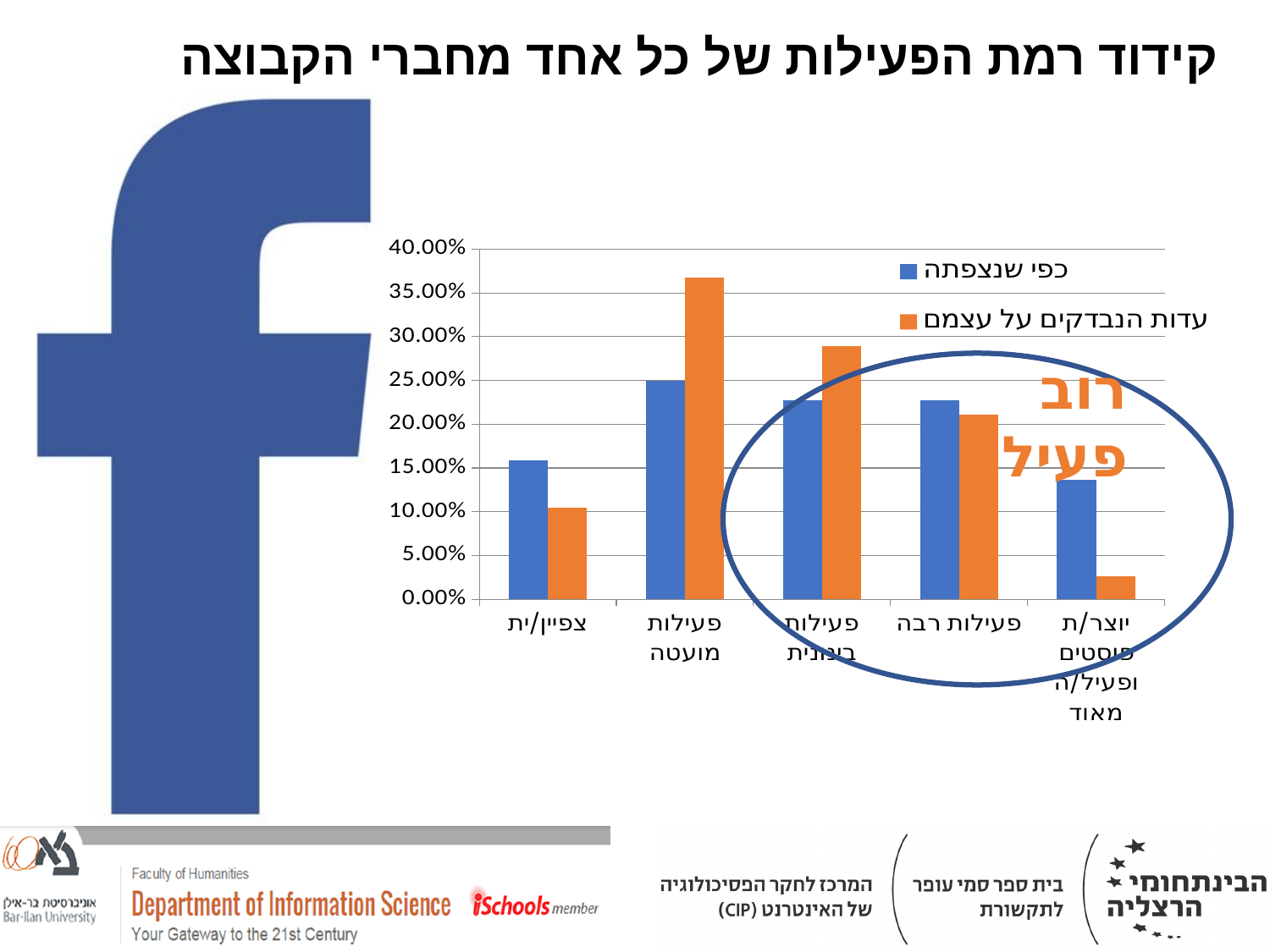
For the category 'צפיין/ית', which series has the larger value: 'כפי שנצפתה' or 'עדות הנבדקים על עצמם'? כפי שנצפתה How many categories are shown on the x axis of the chart? 5 How many series does the chart's legend list? 2 What kind of chart is shown on the slide? bar chart Is the value of 'כפי שנצפתה' for 'פעילות רבה' greater or less than 20.00%? greater For the category 'פעילות מועטה', which series has the larger value: 'כפי שנצפתה' or 'עדות הנבדקים על עצמם'? עדות הנבדקים על עצמם Which category has the lowest value for the series 'עדות הנבדקים על עצמם'? יוצר/ת פוסטים ופעיל/ה מאוד Which category has the highest value for the series 'כפי שנצפתה'? פעילות מועטה Which series is drawn in orange in the chart? עדות הנבדקים על עצמם Which category has the highest value for the series 'עדות הנבדקים על עצמם'? פעילות מועטה Is the value of 'עדות הנבדקים על עצמם' for 'פעילות מועטה' greater or less than 35.00%? greater Is the value of 'עדות הנבדקים על עצמם' for 'יוצר/ת פוסטים ופעיל/ה מאוד' greater or less than 5.00%? less